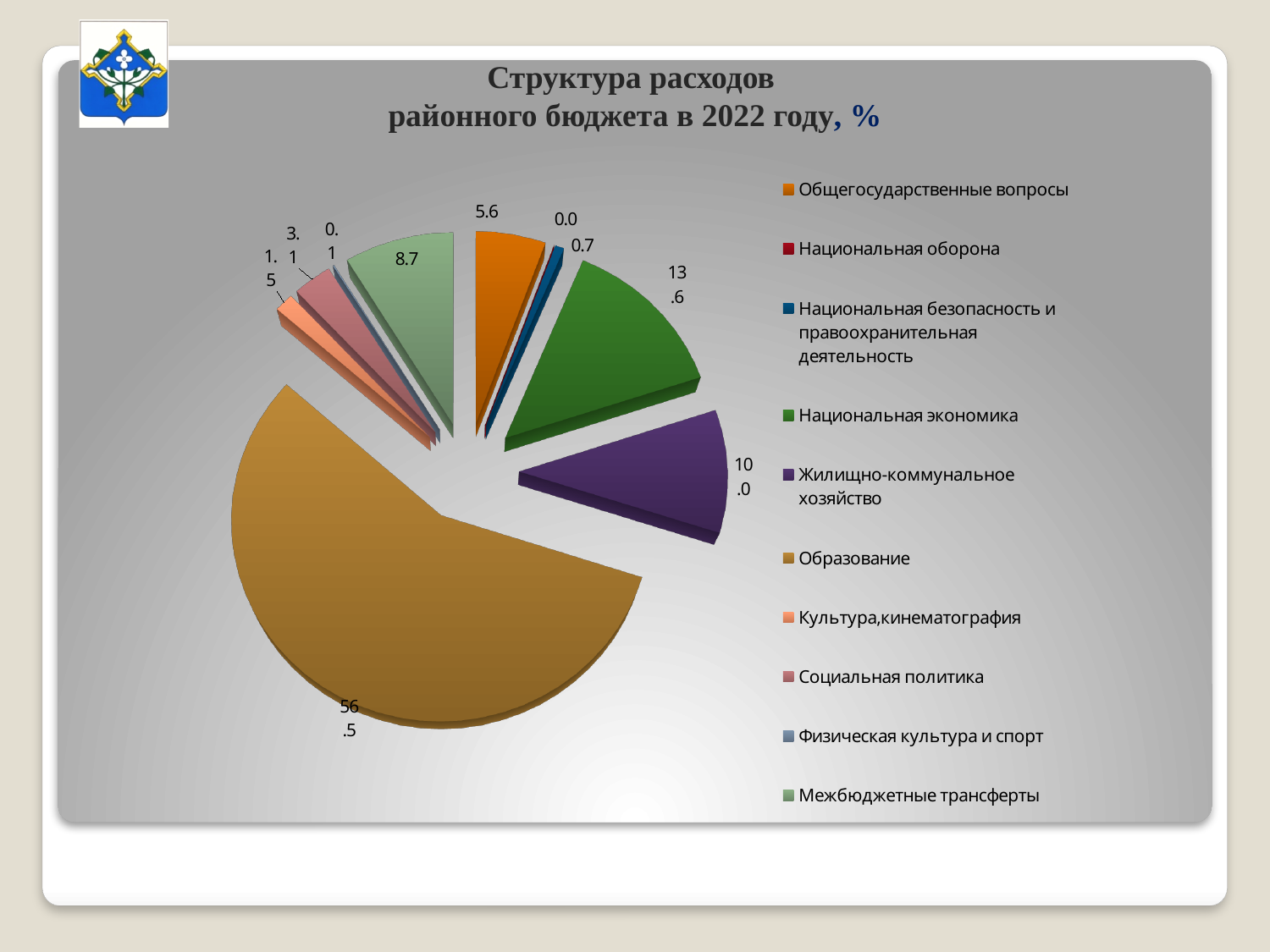
What is the title of the chart? Структура расходов районного бюджета в 2022 году, % What is the difference between the values for Национальная экономика and Жилищно-коммунальное хозяйство? 3.6 What is the value for Жилищно-коммунальное хозяйство? 10.0 What is the value for Национальная экономика? 13.6 What is the value for Межбюджетные трансферты? 8.7 Which category has the largest share of the pie? Образование Which category has the smallest value, Национальная оборона or Национальная экономика? Национальная оборона What is the value for Общегосударственные вопросы? 5.6 What kind of chart is shown on the slide? pie chart What is the value for Образование? 56.5 How many categories does the legend list? 10 Which is larger, the value for Социальная политика or the value for Культура,кинематография? Социальная политика